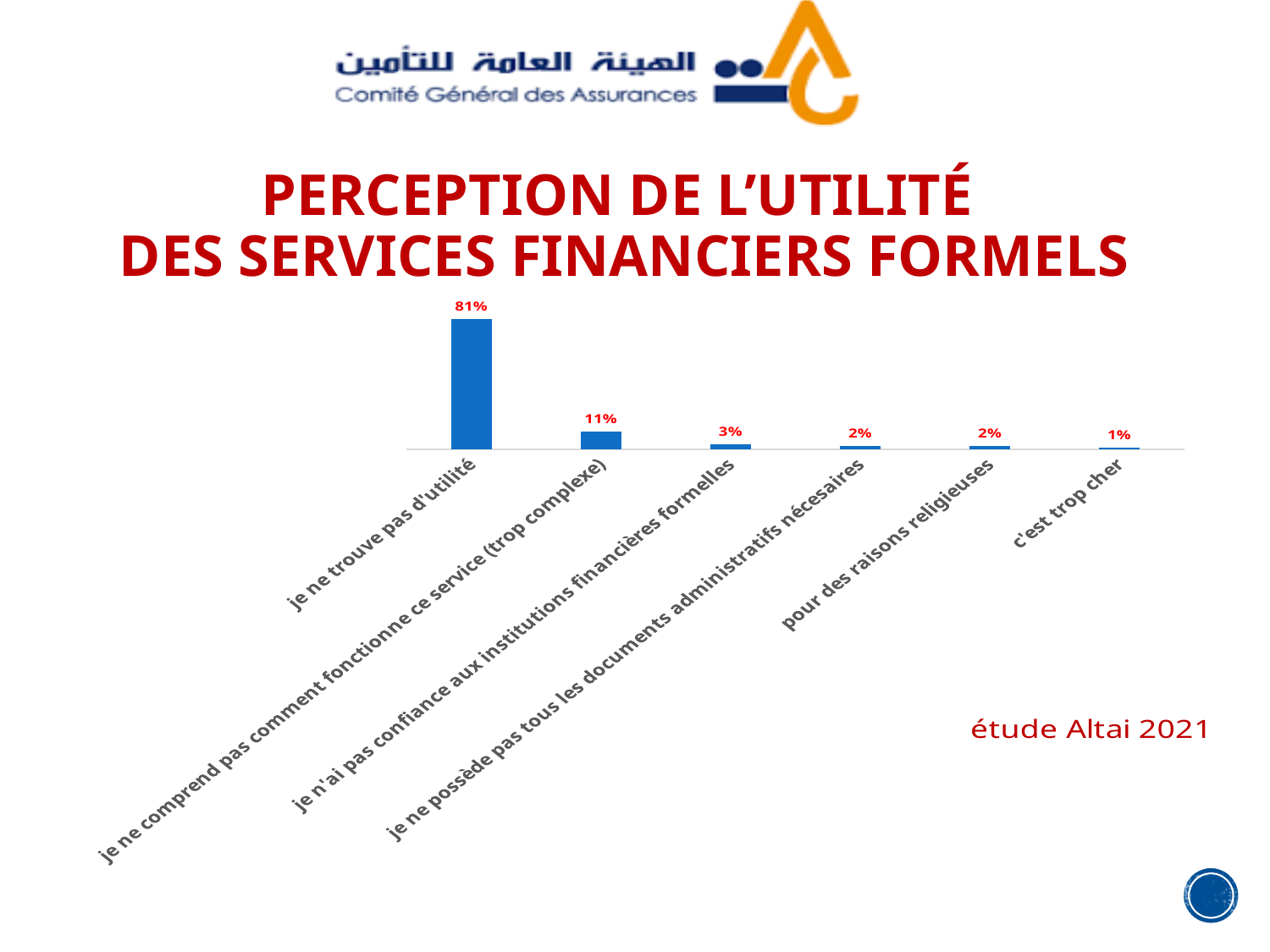
Which category has the highest value? je ne trouve pas d'utilité Which category has the lowest value? c'est trop cher Do the values rise or fall from left to right along the x axis? Fall What is the difference between the values for "je ne trouve pas d'utilité" and "je ne comprend pas comment fonctionne ce service (trop complexe)"? 70% What value is shown for "je ne comprend pas comment fonctionne ce service (trop complexe)"? 11% Which is larger: the value for "je n'ai pas confiance aux institutions financières formelles" or the value for "c'est trop cher"? je n'ai pas confiance aux institutions financières formelles How many categories are shown in the chart? 6 What percentage is shown for "je ne trouve pas d'utilité"? 81% What percentage is shown for "pour des raisons religieuses"? 2% What value is shown for "c'est trop cher"? 1% What kind of chart is shown on the slide? Bar chart What percentage is shown for "je n'ai pas confiance aux institutions financières formelles"? 3%